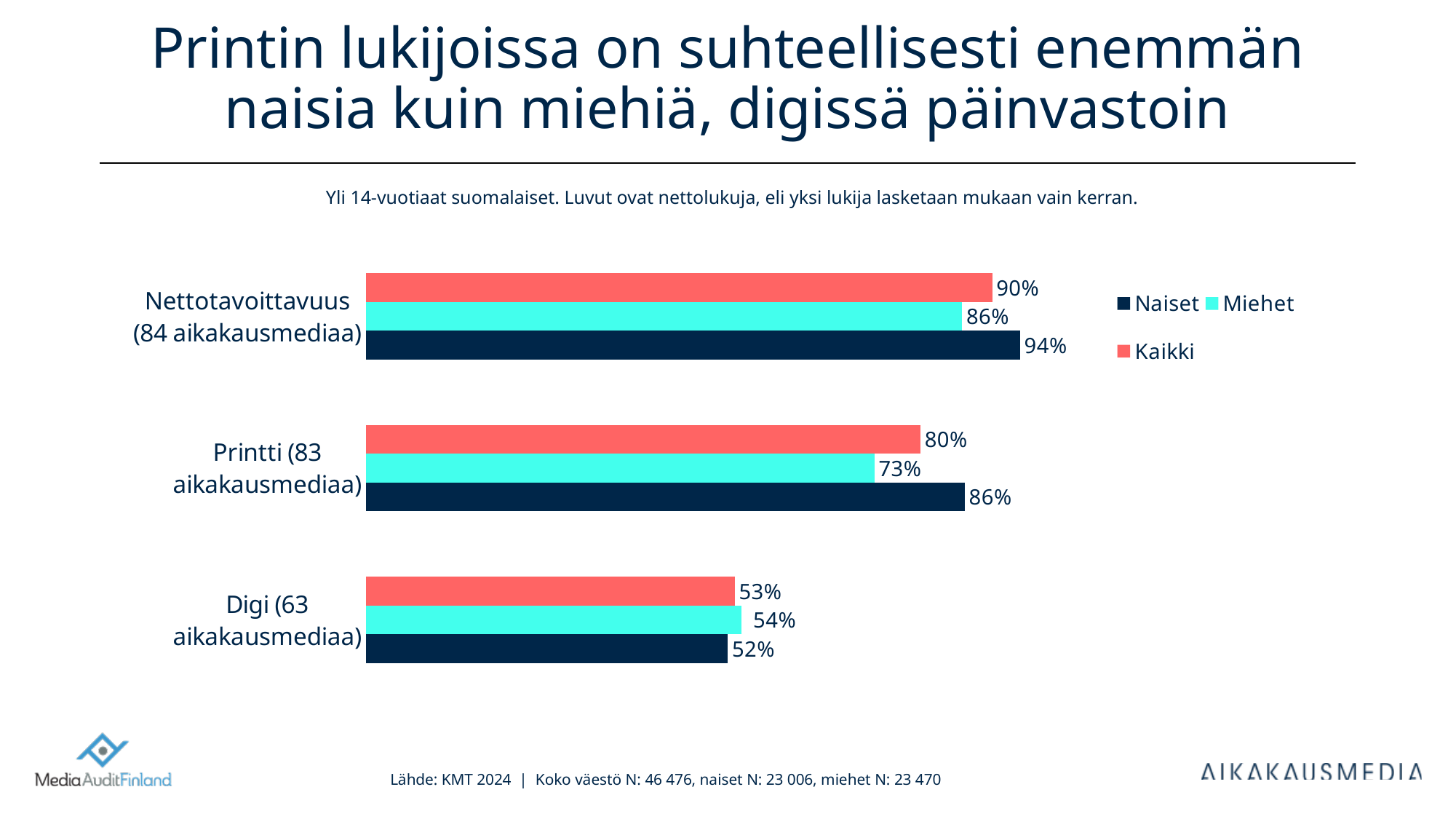
What is the Kaikki value for Digi (63 aikakausmediaa)? 53% For Nettotavoittavuus (84 aikakausmediaa), which is larger: the Naiset value or the Miehet value? Naiset How many series does the legend list? 3 Which category has the highest Naiset value? Nettotavoittavuus (84 aikakausmediaa) What is the Naiset value for Nettotavoittavuus (84 aikakausmediaa)? 94% What kind of chart is shown on the slide? Bar chart What is the difference between the Naiset and Miehet values for Printti (83 aikakausmediaa)? 13 percentage points How many categories are shown on the chart? 3 Which category has the lowest Miehet value? Digi (63 aikakausmediaa) What is the Kaikki value for Printti (83 aikakausmediaa)? 80% Which series is shown in the dark navy colour? Naiset What is the Miehet value for Printti (83 aikakausmediaa)? 73%